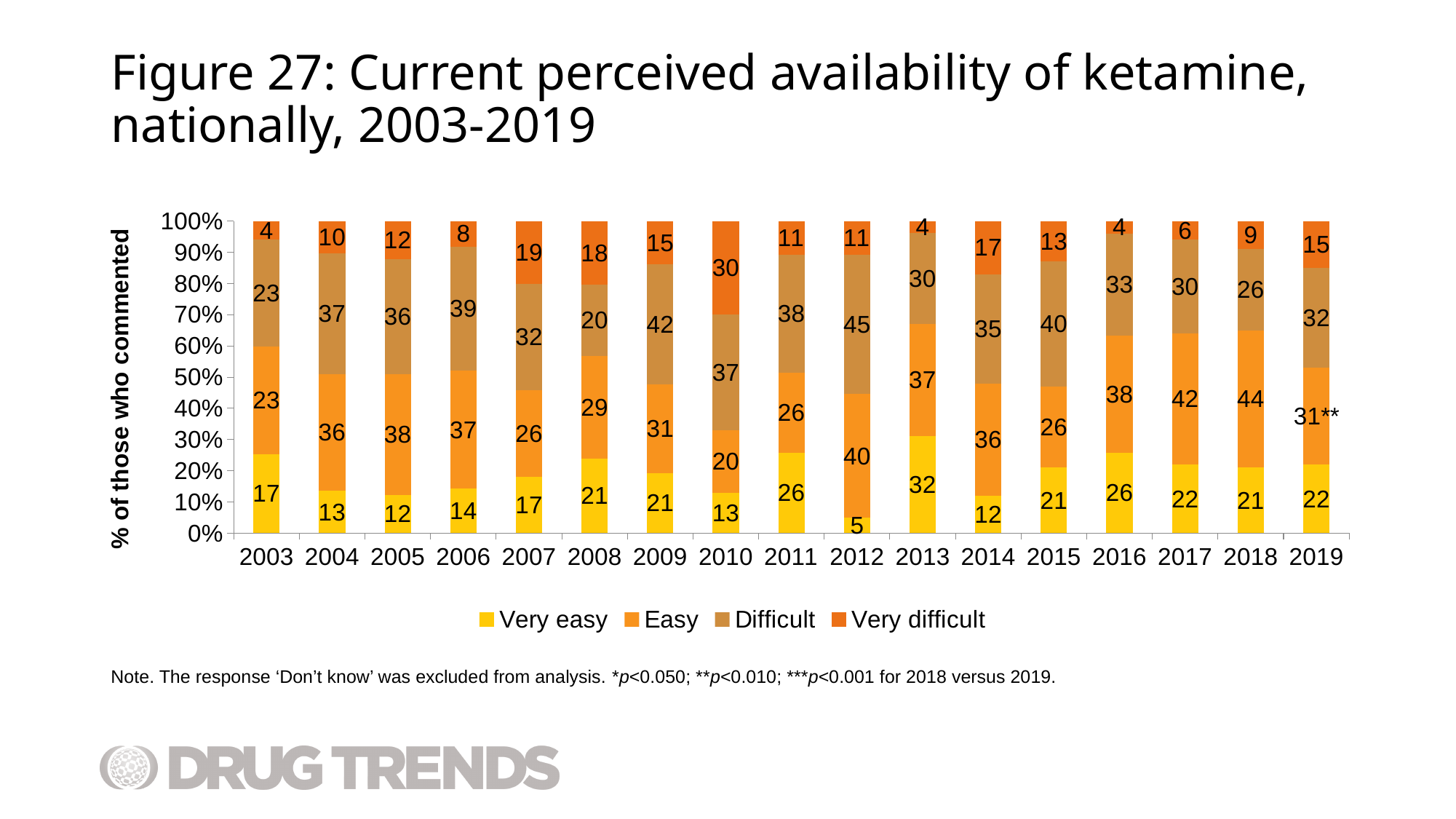
How many years are shown on the x axis? 17 What is the 'Easy' value for 2018? 44 In which year is the 'Very easy' value lowest? 2012 What is the 'Very easy' value for 2013? 32 What kind of chart is shown on the slide? Stacked bar chart What is the label on the vertical axis? % of those who commented What is the difference between the 'Easy' values for 2018 and 2019? 13 How many series does the legend list? 4 What is the 'Difficult' value for 2012? 45 What is the 'Very difficult' value for 2010? 30 In which year is the 'Very difficult' value highest? 2010 Which is larger, the 'Difficult' value for 2009 or for 2015? 2009